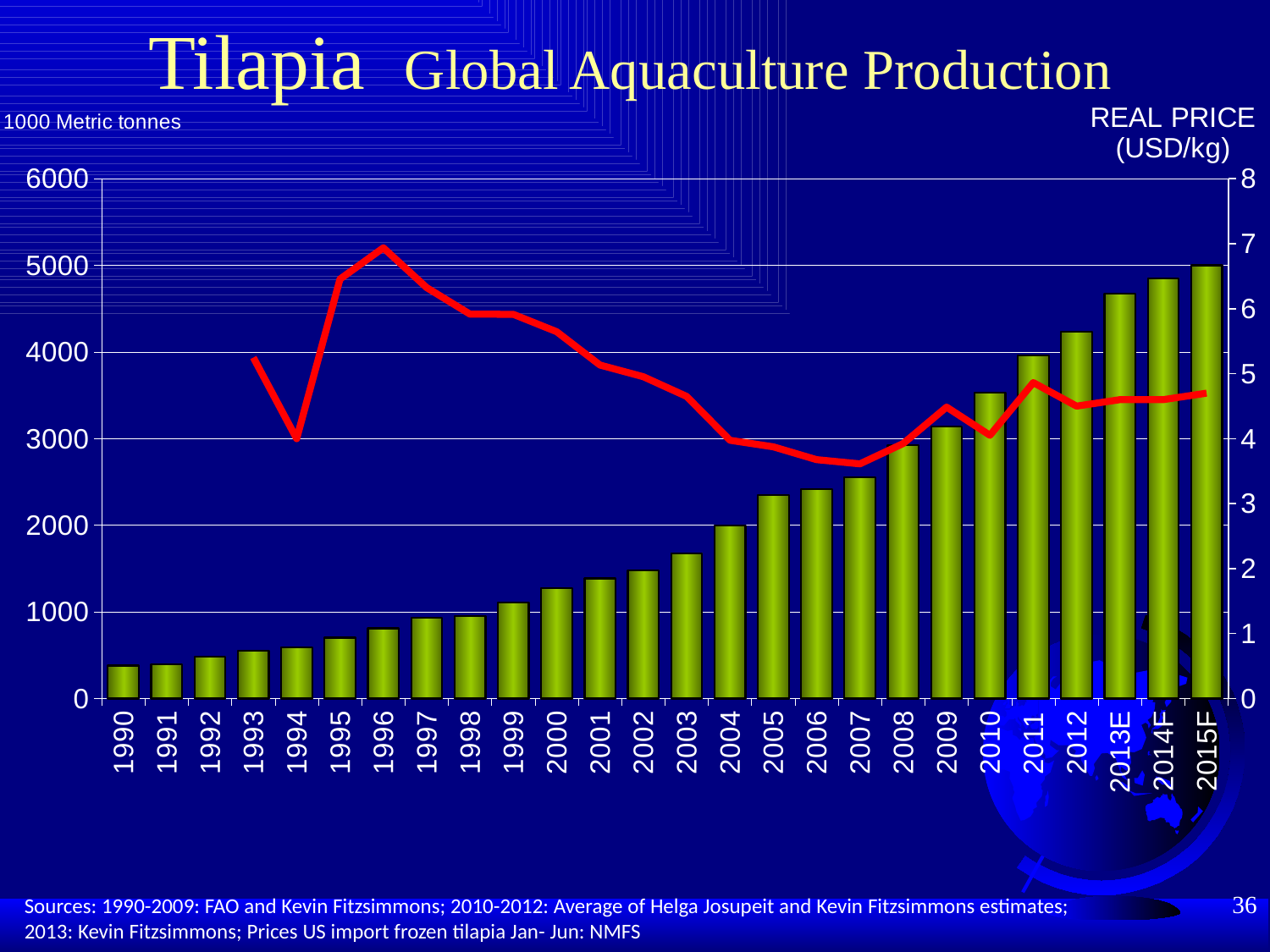
What unit is given for the left axis? 1000 Metric tonnes Do the production bars generally rise or fall from 1990 to 2015F? rise Is the real price for 1996 greater or less than 6 USD/kg? greater Is the production value for 1990 greater or less than 1000? less Is the production value for 2014F greater or less than 5000? less Which year has the highest production bar? 2015F Which year has the larger production bar, 2009 or 2012? 2012 What kind of chart is used to show the global aquaculture production values? bar chart How many years (categories) are shown on the x axis? 26 Which year has the lowest production bar? 1990